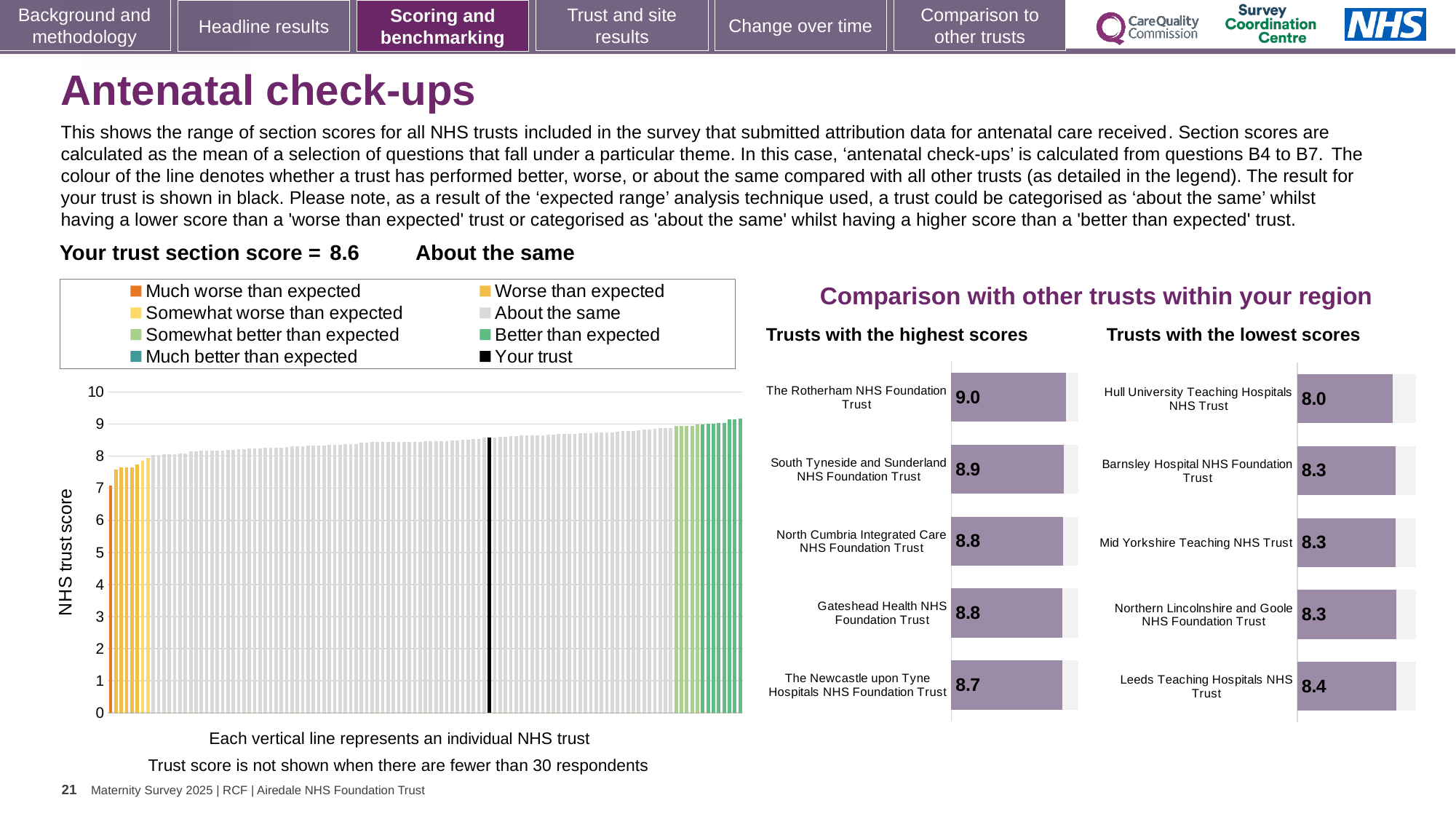
In the 'Trusts with the highest scores' chart, what is the difference between the scores of The Rotherham NHS Foundation Trust and The Newcastle upon Tyne Hospitals NHS Foundation Trust? 0.3 In the 'Trusts with the lowest scores' chart, which trust has the highest score? Leeds Teaching Hospitals NHS Trust In the main chart on the left showing all NHS trusts, do the trust scores rise or fall from left to right? rise In the 'Trusts with the lowest scores' chart, which trust has the lowest score? Hull University Teaching Hospitals NHS Trust How many entries does the legend above the main chart on the left list? 8 In the main chart on the left showing all NHS trusts, is the value for the black 'Your trust' bar greater or less than 8? greater Which has a higher score: South Tyneside and Sunderland NHS Foundation Trust in the highest scores chart, or Barnsley Hospital NHS Foundation Trust in the lowest scores chart? South Tyneside and Sunderland NHS Foundation Trust In the 'Trusts with the lowest scores' chart, what is the score for Hull University Teaching Hospitals NHS Trust? 8.0 In the 'Trusts with the highest scores' chart, what is the score for The Rotherham NHS Foundation Trust? 9.0 In the 'Trusts with the lowest scores' chart, what is the difference between the scores of Leeds Teaching Hospitals NHS Trust and Hull University Teaching Hospitals NHS Trust? 0.4 In the 'Trusts with the highest scores' chart, what is the score for The Newcastle upon Tyne Hospitals NHS Foundation Trust? 8.7 In the 'Trusts with the highest scores' chart, how many trusts are listed? 5